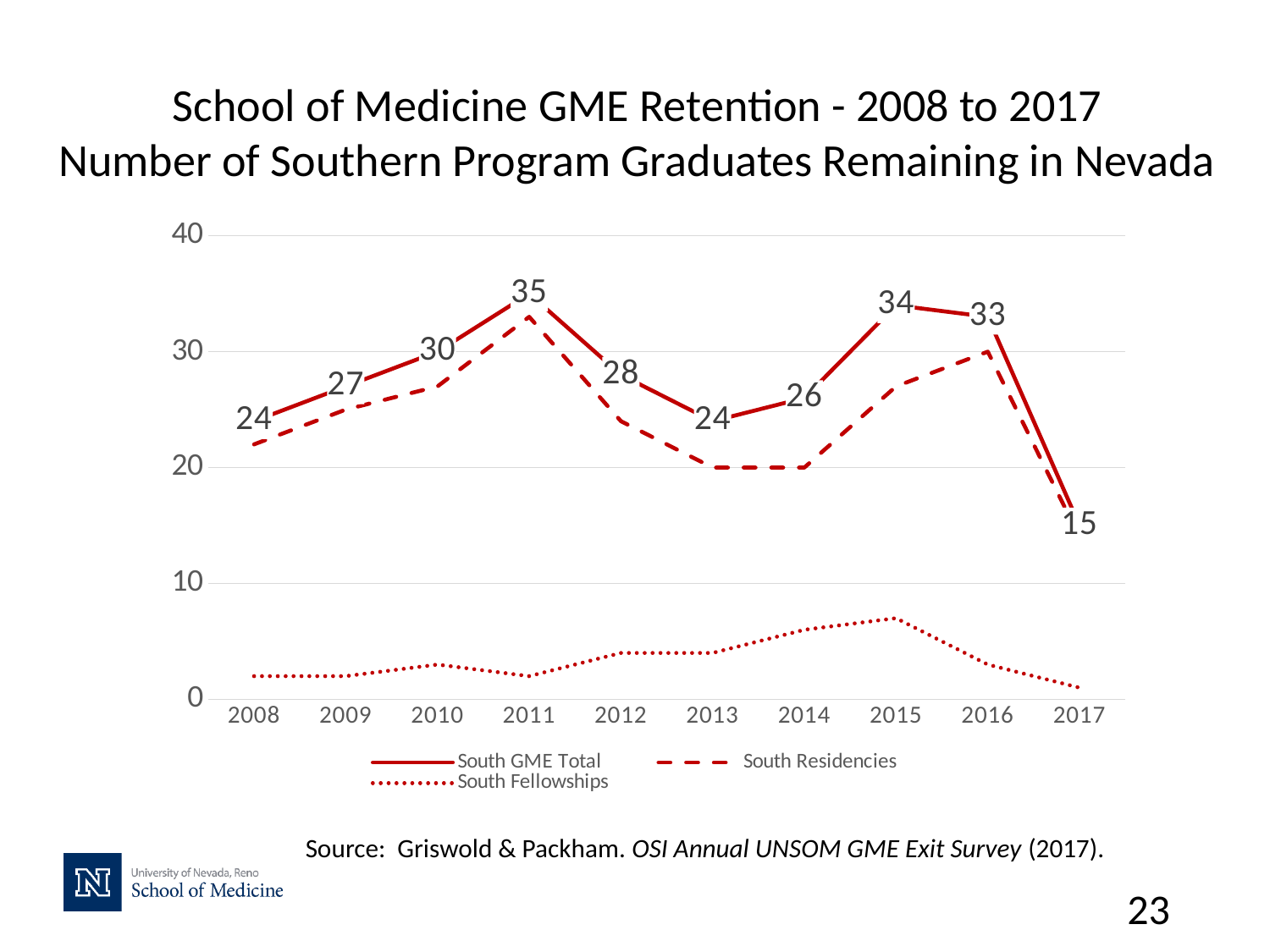
Is the South Fellowships value for 2015 greater or less than 10? less How many series does the legend list? 3 What type of chart is shown on the slide? line chart In which year is the South GME Total highest? 2011 How many years are shown on the x axis? 10 What is the South GME Total value for 2015? 34 What is the difference between the South GME Total in 2016 and in 2017? 18 Which is larger, the South GME Total in 2010 or in 2012? 2010 Does the South GME Total rise or fall from 2016 to 2017? fall In which year is the South GME Total lowest? 2017 What is the South GME Total value for 2011? 35 What is the South GME Total value for 2017? 15